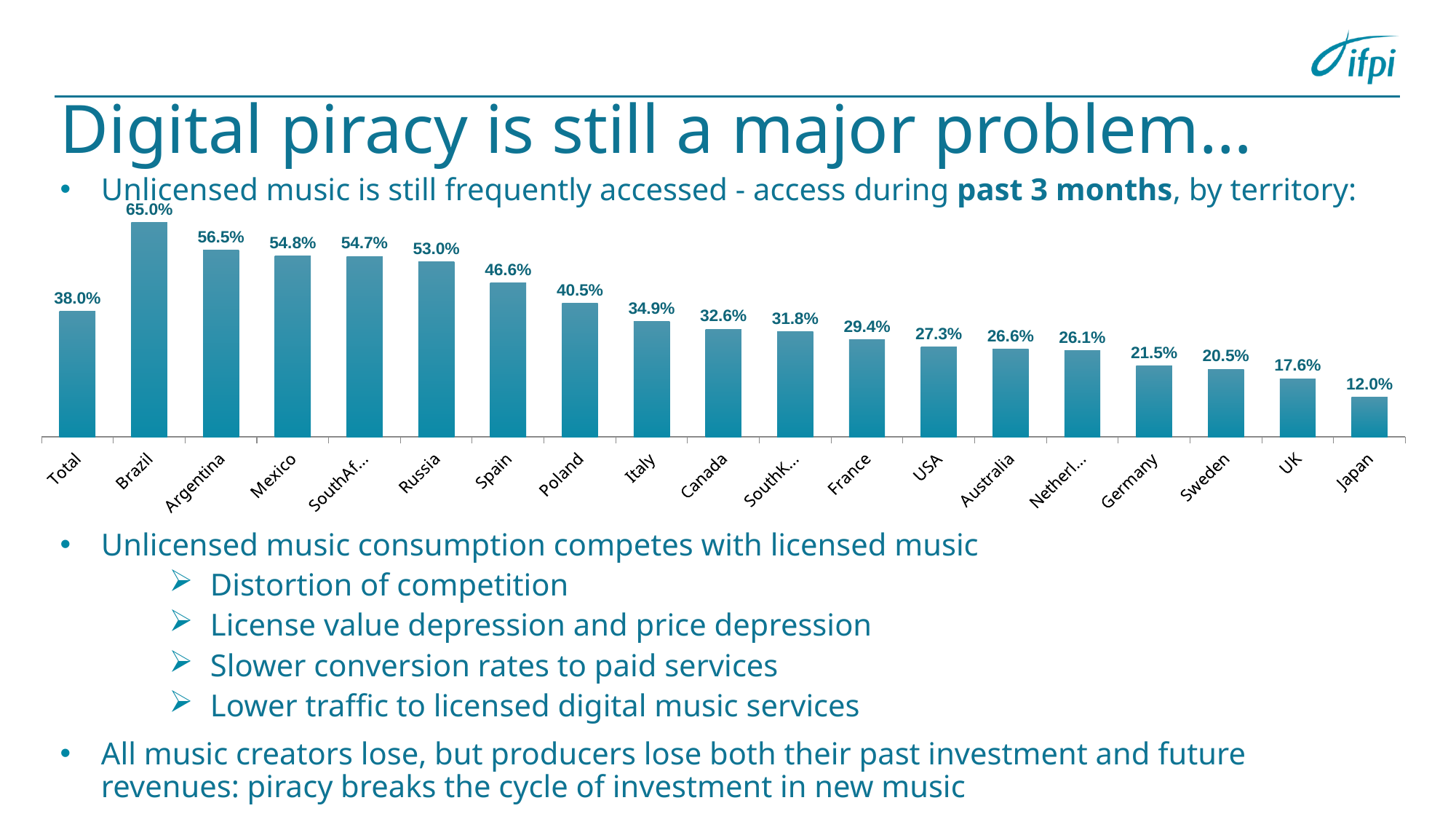
Which is larger, the value for Spain or the value for Poland? Spain Which territory has the highest value? Brazil What is the value for Total? 38.0% What kind of chart is shown on the slide? Bar chart What is the value for Japan? 12.0% What is the difference between the values for UK and Japan? 5.6% How many bars are shown in the chart? 19 Do the values rise or fall from Brazil to Japan along the x axis? Fall What is the value for Brazil? 65.0% What is the difference between the values for Brazil and Total? 27.0% Which territory has the lowest value? Japan What is the value for Germany? 21.5%